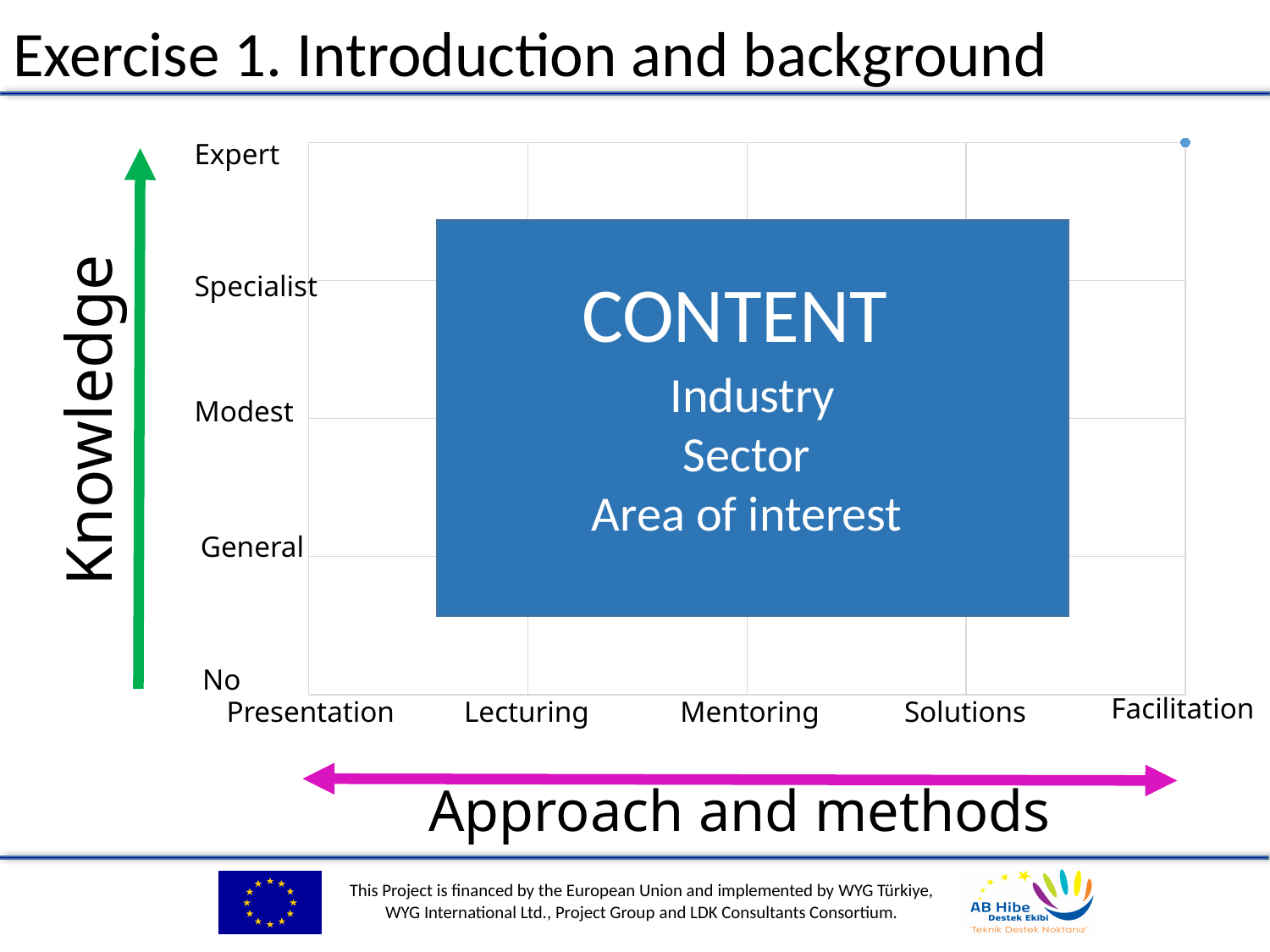
How many data points are plotted on the chart? 1 What is the title of the horizontal axis of the chart? Approach and methods How many knowledge levels are labelled along the y axis of the chart? 5 Which label is at the bottom of the y axis of the chart? No What is the title of the vertical axis of the chart? Knowledge Which category is the first (leftmost) on the x axis of the chart? Presentation Which knowledge level does the plotted point at Facilitation land on? Expert Which x-axis category does the single plotted point belong to? Facilitation Which label is at the top of the y axis of the chart? Expert How many categories are labelled along the x axis of the chart? 5